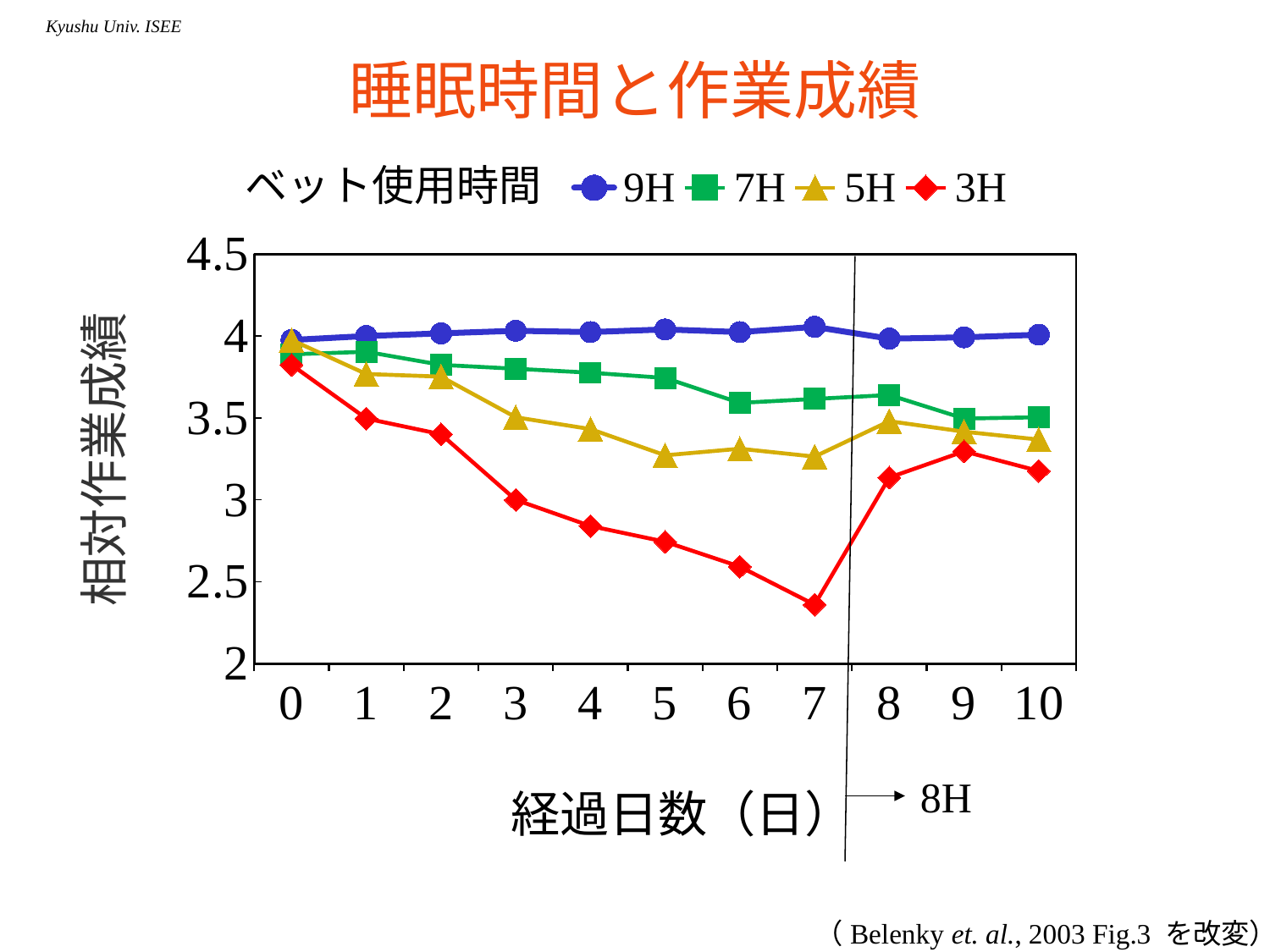
At day 3, which series has the larger value, 7H or 5H? 7H Does the 3H series rise or fall from day 0 to day 7? fall Which series has the highest value at day 7? 9H What is the title of the chart? 睡眠時間と作業成績 Is the value for the 3H series at day 7 greater or less than 2.5? less At which day does the 3H series reach its lowest value? 7 How many days (x-axis points) are plotted for each series? 11 Which series has the lowest value at day 7? 3H What kind of chart is shown on the slide? line chart Is the value for the 5H series at day 5 greater or less than 3.5? less How many series does the legend list? 4 Is the value for the 3H series at day 4 greater or less than 3? less